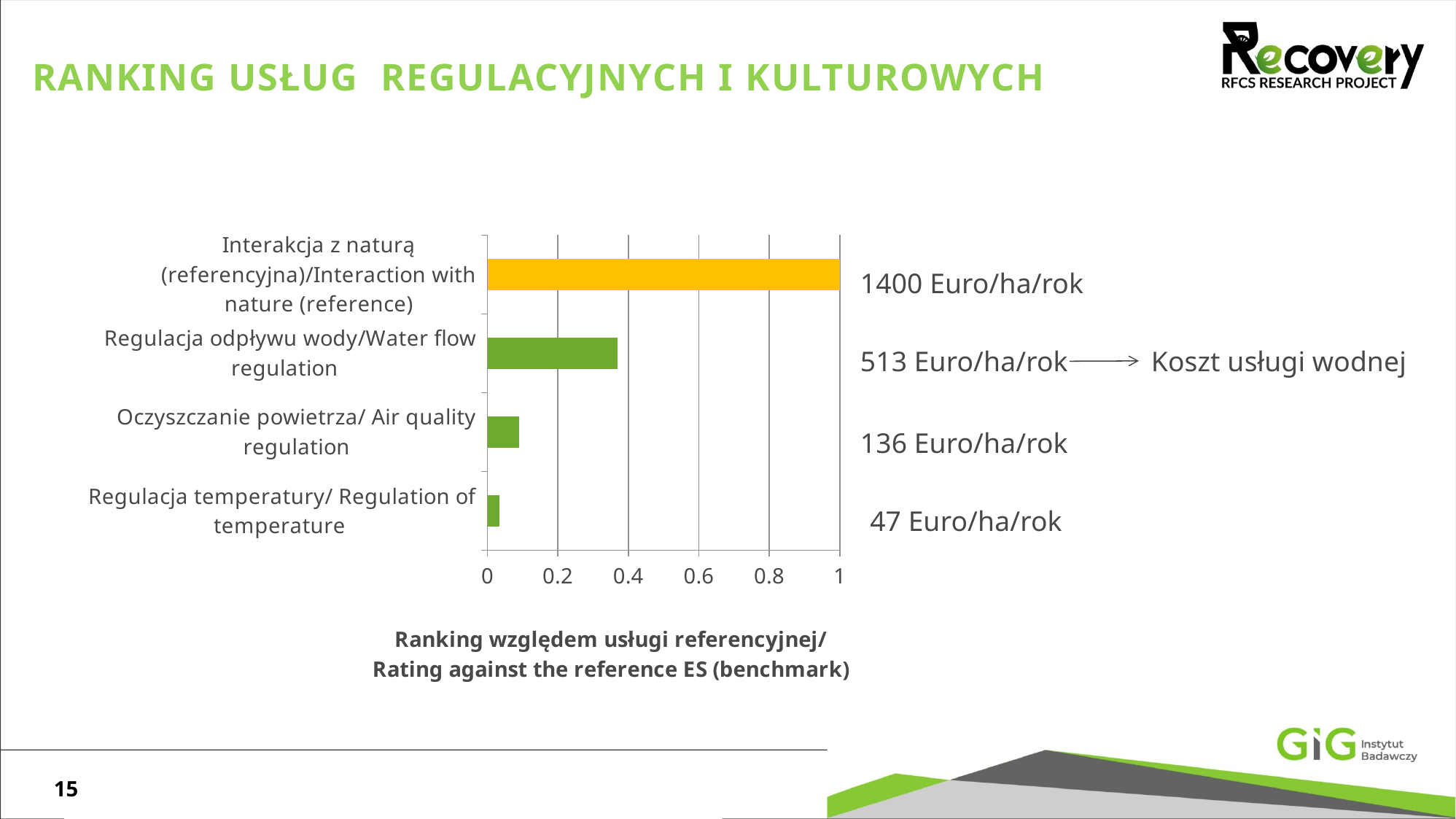
What is the difference in Euro/ha/rok between the Interaction with nature value and the Water flow regulation value? 887 Euro/ha/rok Is the rating for Air quality regulation greater or less than 0.2? less How many categories does the bar chart show? 4 Which category has the highest rating against the reference ES? Interakcja z naturą (referencyjna)/Interaction with nature (reference) Is the rating for Water flow regulation greater or less than 0.4? less What is the rating value of the reference service, Interaction with nature? 1 Which has a higher rating, Water flow regulation or Air quality regulation? Water flow regulation Which category has the lowest rating against the reference ES? Regulacja temperatury/ Regulation of temperature What value in Euro/ha/rok is shown next to the Regulation of temperature bar? 47 Euro/ha/rok What value in Euro/ha/rok is shown next to the Water flow regulation bar? 513 Euro/ha/rok What kind of chart is shown on the slide? bar chart What value in Euro/ha/rok is shown next to the Air quality regulation bar? 136 Euro/ha/rok